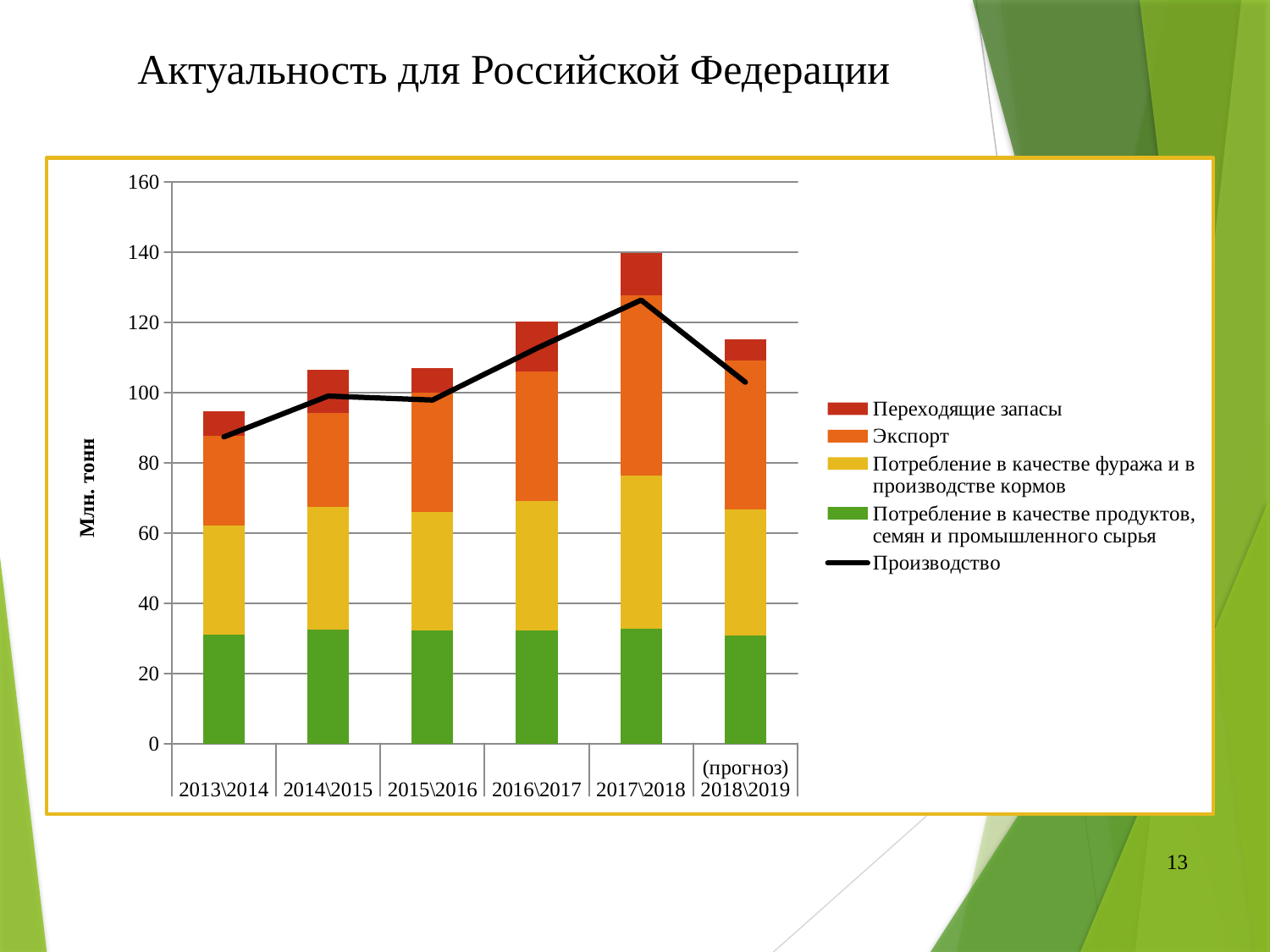
How many series does the legend list? 5 Is the Производство value for 2018\2019 (прогноз) greater or less than 120? less Which season has the tallest stacked bar? 2017\2018 Is the total of the stacked bar for 2017\2018 greater or less than 120? greater In which season does the Производство line reach its highest point? 2017\2018 Is the Производство value for 2013\2014 greater or less than 100? less How many seasons (categories) are shown on the x axis? 6 What is the label of the vertical axis? Млн. тонн Which is larger: the Производство value for 2017\2018 or for 2018\2019 (прогноз)? 2017\2018 Which season has the shortest stacked bar? 2013\2014 Does the Производство line rise or fall from 2013\2014 to 2017\2018? rise What kind of chart is shown on the slide? Stacked bar chart with a line